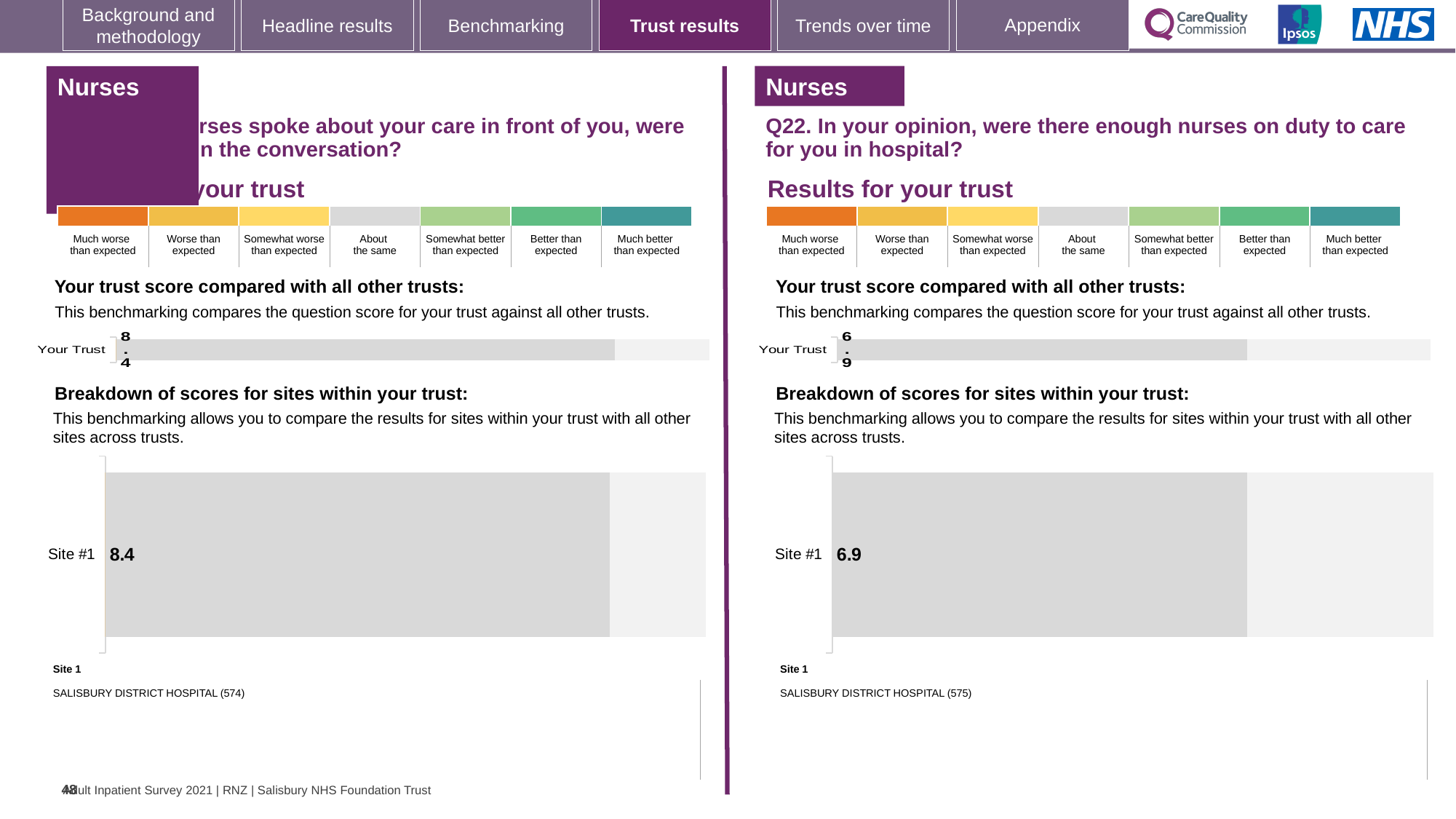
In the left 'Breakdown of scores for sites within your trust' chart, what is the value for Site #1? 8.4 What type of chart is used to show the Your Trust score on the left half of the slide? Bar chart Which is larger: the Site #1 value in the left breakdown chart or the Site #1 value in the right breakdown chart? The left chart (8.4) On the left half of the slide, what is the value shown for Your Trust in the 'Your trust score compared with all other trusts' chart? 8.4 In the right 'Breakdown of scores for sites within your trust' chart (Q22), what is the value for Site #1? 6.9 How many sites are plotted in the left 'Breakdown of scores for sites within your trust' chart? 1 Which site is listed as Site 1 below the left breakdown chart? SALISBURY DISTRICT HOSPITAL (574) Which site is listed as Site 1 below the right breakdown chart (Q22)? SALISBURY DISTRICT HOSPITAL (575) How many sites are plotted in the right 'Breakdown of scores for sites within your trust' chart (Q22)? 1 What is the difference between the Your Trust value on the left half of the slide and the Your Trust value on the right half (Q22)? 1.5 What type of chart is used to show the Site #1 score in the right breakdown chart (Q22)? Bar chart On the right half of the slide (Q22), what is the value shown for Your Trust in the 'Your trust score compared with all other trusts' chart? 6.9